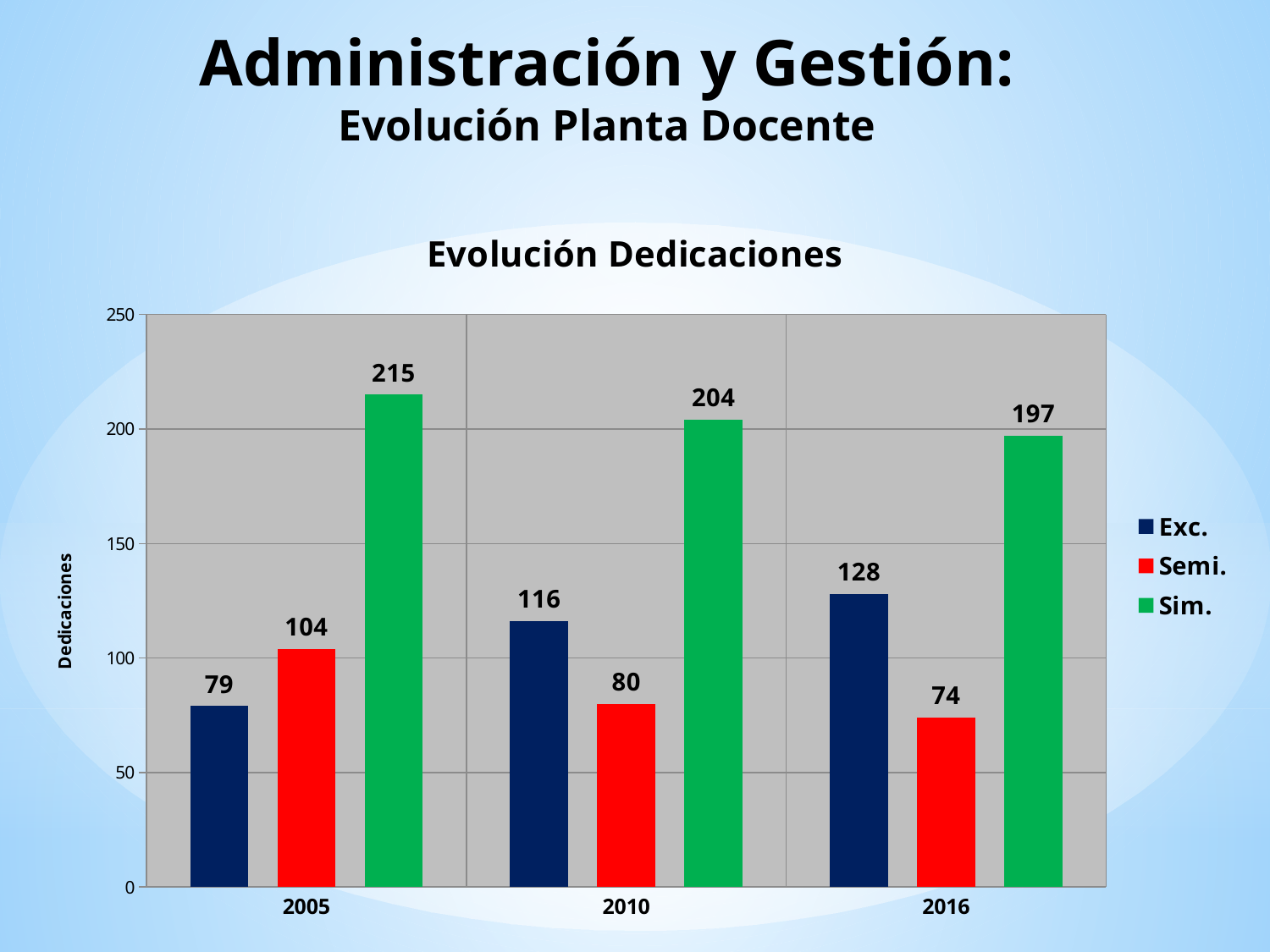
What is the value for Exc. in 2005? 79 What is the value for Sim. in 2010? 204 What is the value for Semi. in 2016? 74 Which year has the lowest value for Exc.? 2005 Is the value for Exc. in 2016 greater or less than 150? less What kind of chart is shown? bar chart How many series does the legend list? 3 How many years are shown on the x axis? 3 Which is larger in 2010, Exc. or Semi.? Exc. Does the value for Exc. rise or fall from 2005 to 2016? rise What is the difference between the Sim. value in 2005 and the Sim. value in 2016? 18 Which year has the highest value for Sim.? 2005